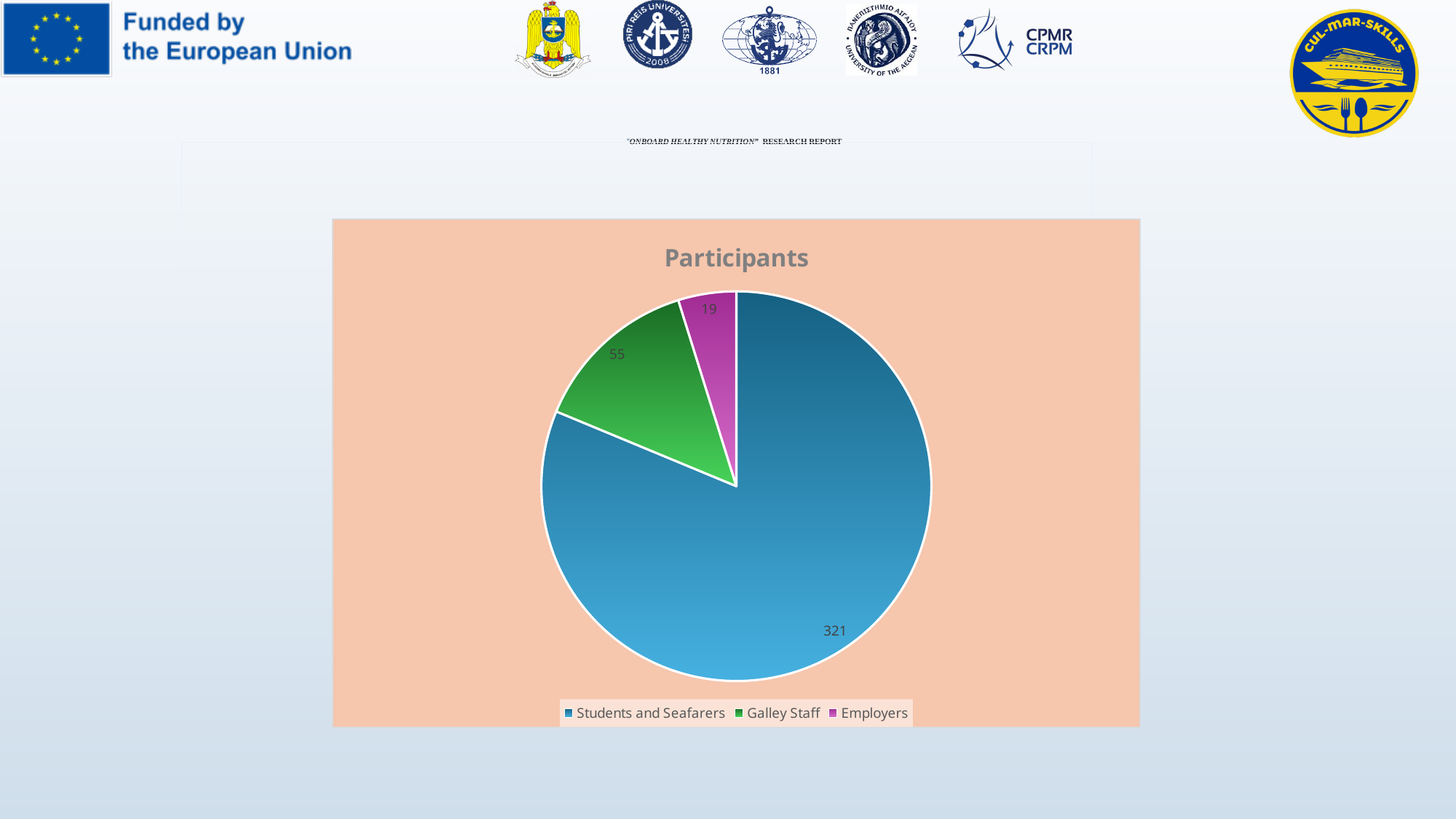
Which category has the largest slice in the Participants pie chart? Students and Seafarers What is the value for Galley Staff in the Participants pie chart? 55 Which category has the smallest slice in the Participants pie chart? Employers What is the total of all slices in the Participants pie chart? 395 What is the value for Employers in the Participants pie chart? 19 What is the difference between the Students and Seafarers value and the Galley Staff value? 266 How many categories are shown in the Participants pie chart? 3 What is the difference between the Galley Staff value and the Employers value? 36 Which is larger, Galley Staff or Employers? Galley Staff What is the value for Students and Seafarers in the Participants pie chart? 321 What is the title of the chart on the slide? Participants What kind of chart is shown on the slide? Pie chart